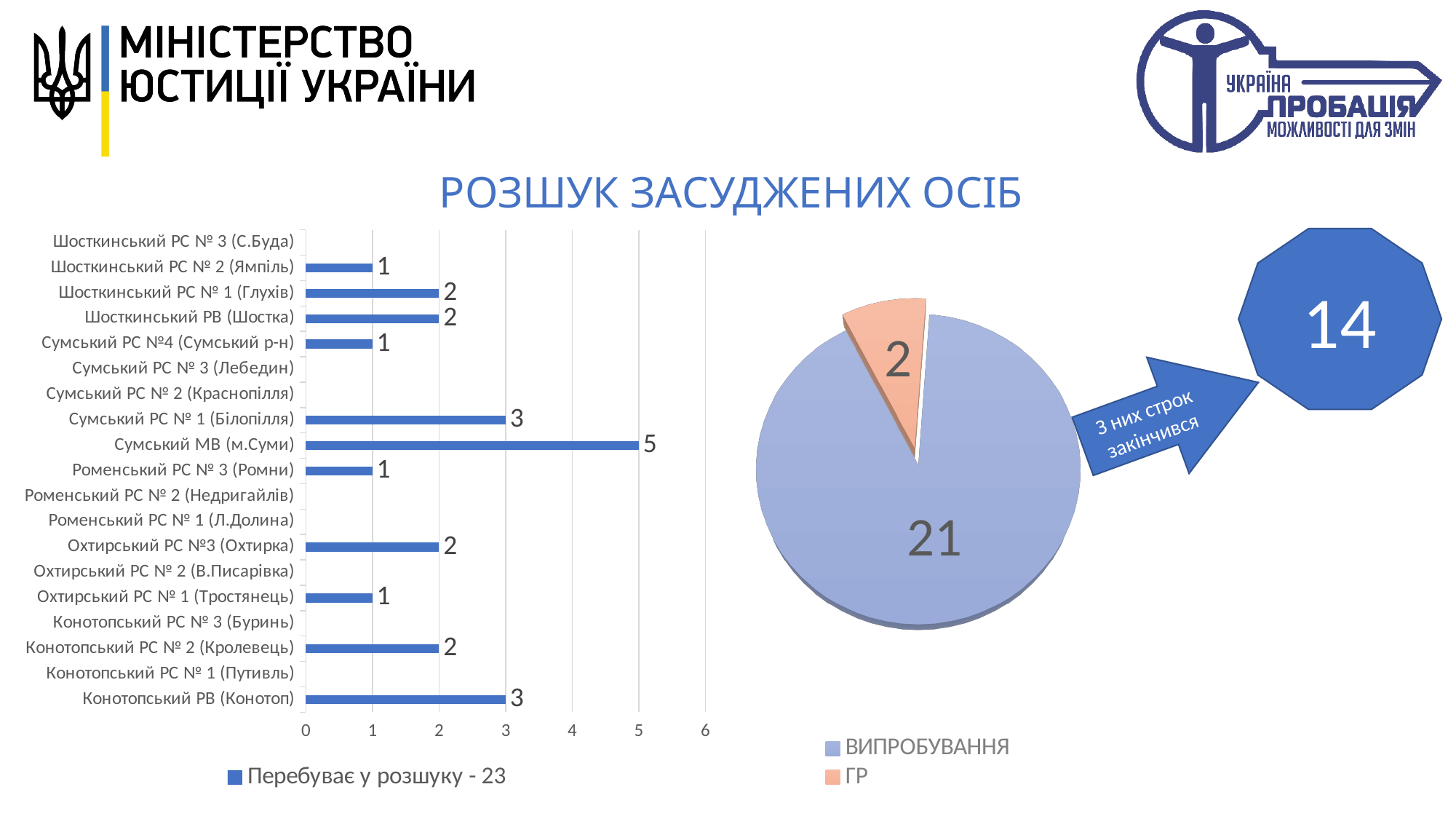
In the bar chart on the left, which category has the highest value? Сумський МВ (м.Суми) In the pie chart on the right, what is the value for ВИПРОБУВАННЯ? 21 In the bar chart on the left, what does the legend entry say? Перебуває у розшуку - 23 What kind of chart is the chart on the left? Bar chart In the bar chart on the left, what is the value for Сумський МВ (м.Суми)? 5 In the pie chart on the right, how many entries does the legend list? 2 In the pie chart on the right, what is the value for ГР? 2 In the bar chart on the left, which is larger: the value for Шосткинський РВ (Шостка) or the value for Охтирський РС № 1 (Тростянець)? Шосткинський РВ (Шостка) What kind of chart is the chart on the right? Pie chart In the bar chart on the left, what is the difference between the values for Сумський МВ (м.Суми) and Сумський РС № 1 (Білопілля)? 2 In the bar chart on the left, how many categories are listed on the vertical axis? 19 In the bar chart on the left, what is the value for Конотопський РВ (Конотоп)? 3